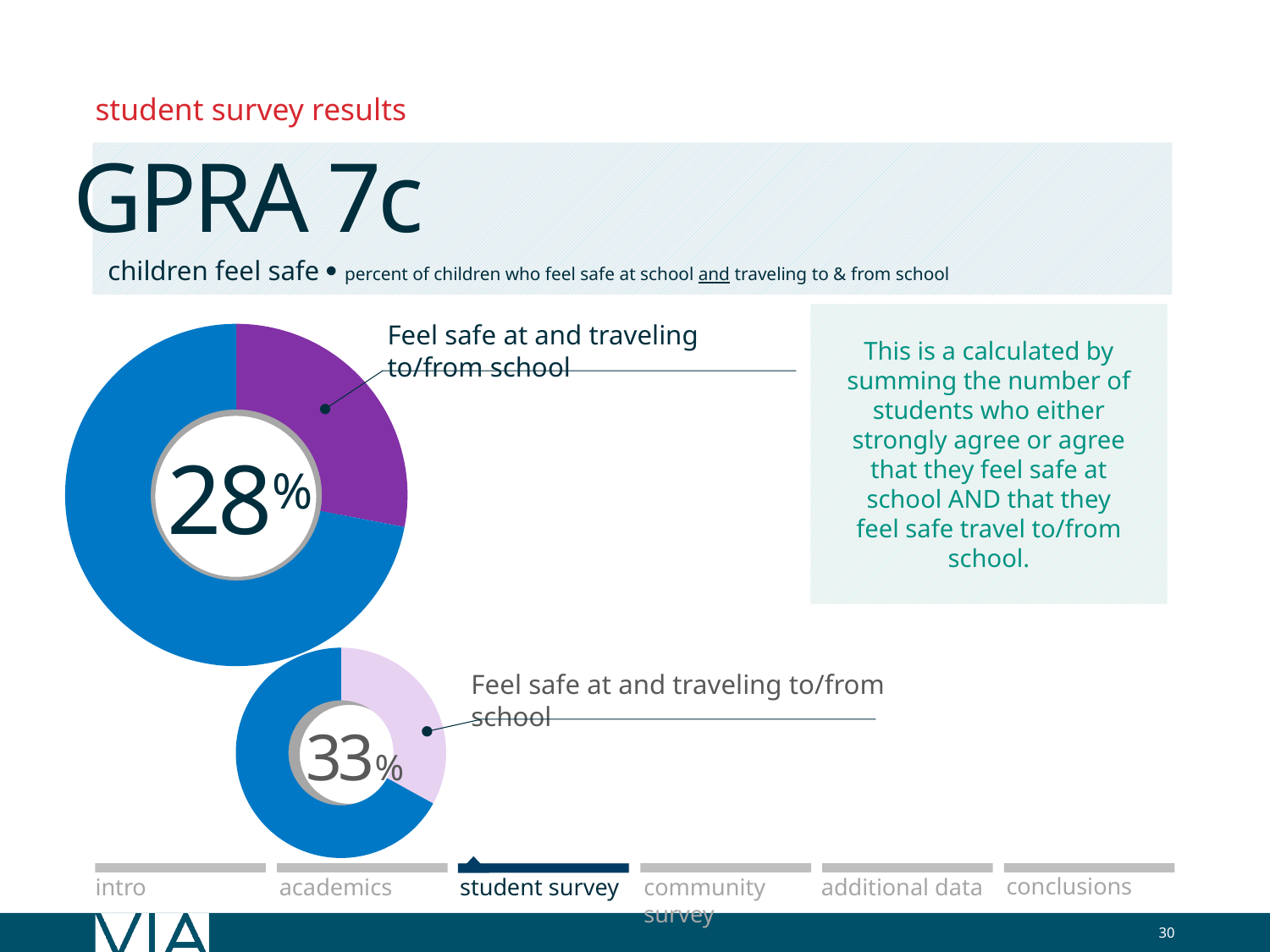
What percentage is shown in the centre of the larger donut chart at the upper left of the slide? 28% In the larger upper donut chart, what share of the whole does the purple slice labelled 'Feel safe at and traveling to/from school' represent? 28% What label is attached to the highlighted slice of the larger upper donut chart? Feel safe at and traveling to/from school What colour is the highlighted slice in the larger upper donut chart? Purple What percentage is shown in the centre of the smaller donut chart at the lower left of the slide? 33% Which chart shows the larger percentage of children who feel safe at and traveling to/from school, the larger upper donut or the smaller lower donut? The smaller lower donut (33%) What is the difference in percentage points between the value in the smaller lower donut chart and the value in the larger upper donut chart? 5 percentage points What kind of chart is the larger chart at the upper left of the slide? Donut (pie) chart How many donut charts are shown on the slide? 2 What kind of chart is the smaller chart at the lower left of the slide? Donut (pie) chart In the smaller lower donut chart, what share of the whole does the light purple slice labelled 'Feel safe at and traveling to/from school' represent? 33%